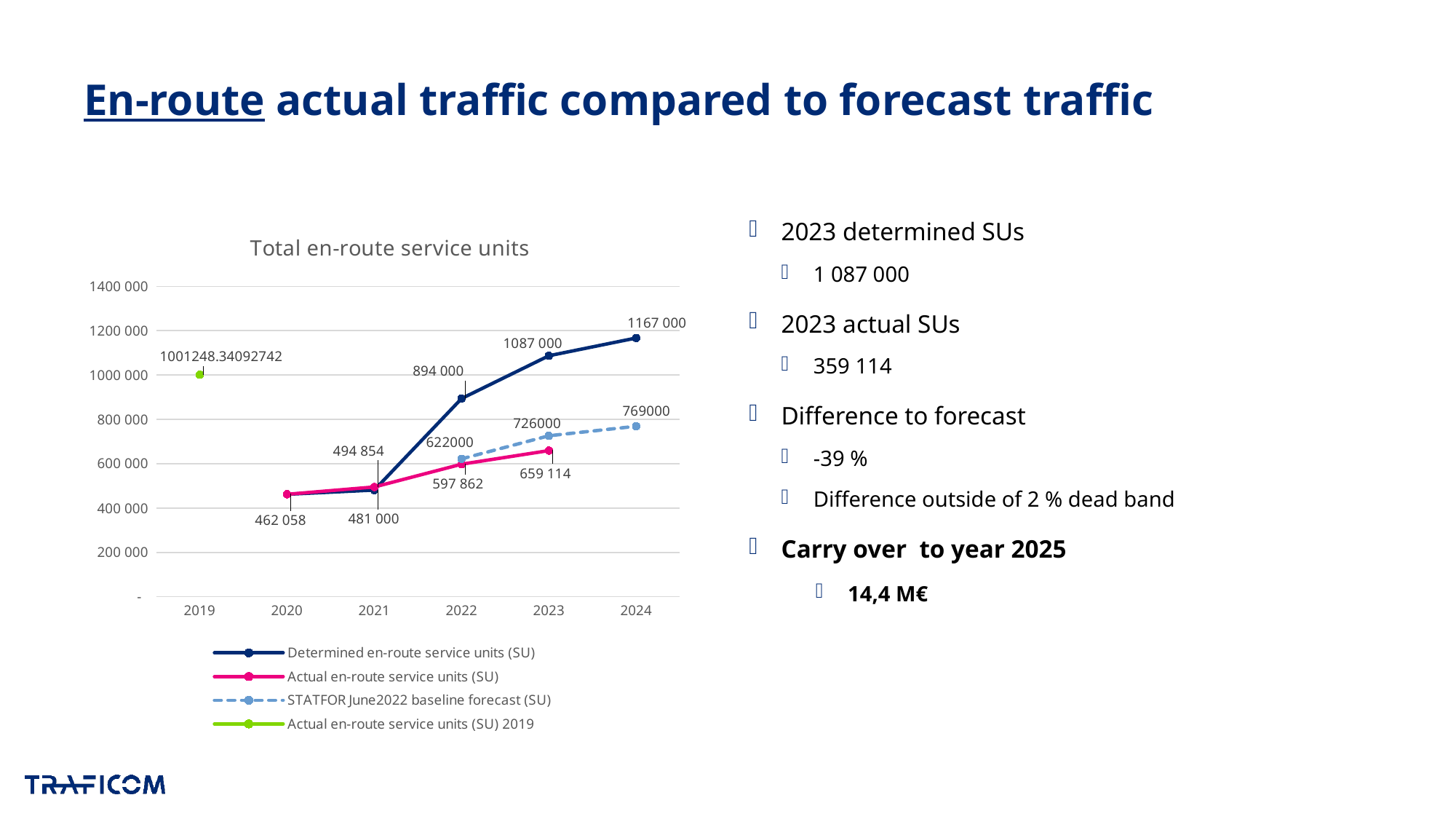
How many series does the legend list? 4 What is the STATFOR June2022 baseline forecast (SU) value for 2024? 769000 What type of chart is shown on the slide? line chart What is the difference between Determined en-route service units (SU) and Actual en-route service units (SU) in 2023? 427 886 How many years are shown on the x axis? 6 What is the value of Determined en-route service units (SU) for 2022? 894 000 Does the Determined en-route service units (SU) series rise or fall from 2021 to 2024? rise What is the value of Actual en-route service units (SU) for 2023? 659 114 What is the value of Determined en-route service units (SU) for 2024? 1167 000 In 2023, which is larger: Determined en-route service units (SU) or Actual en-route service units (SU)? Determined en-route service units (SU) What is the value of Actual en-route service units (SU) for 2022? 597 862 What is the title of the chart? Total en-route service units